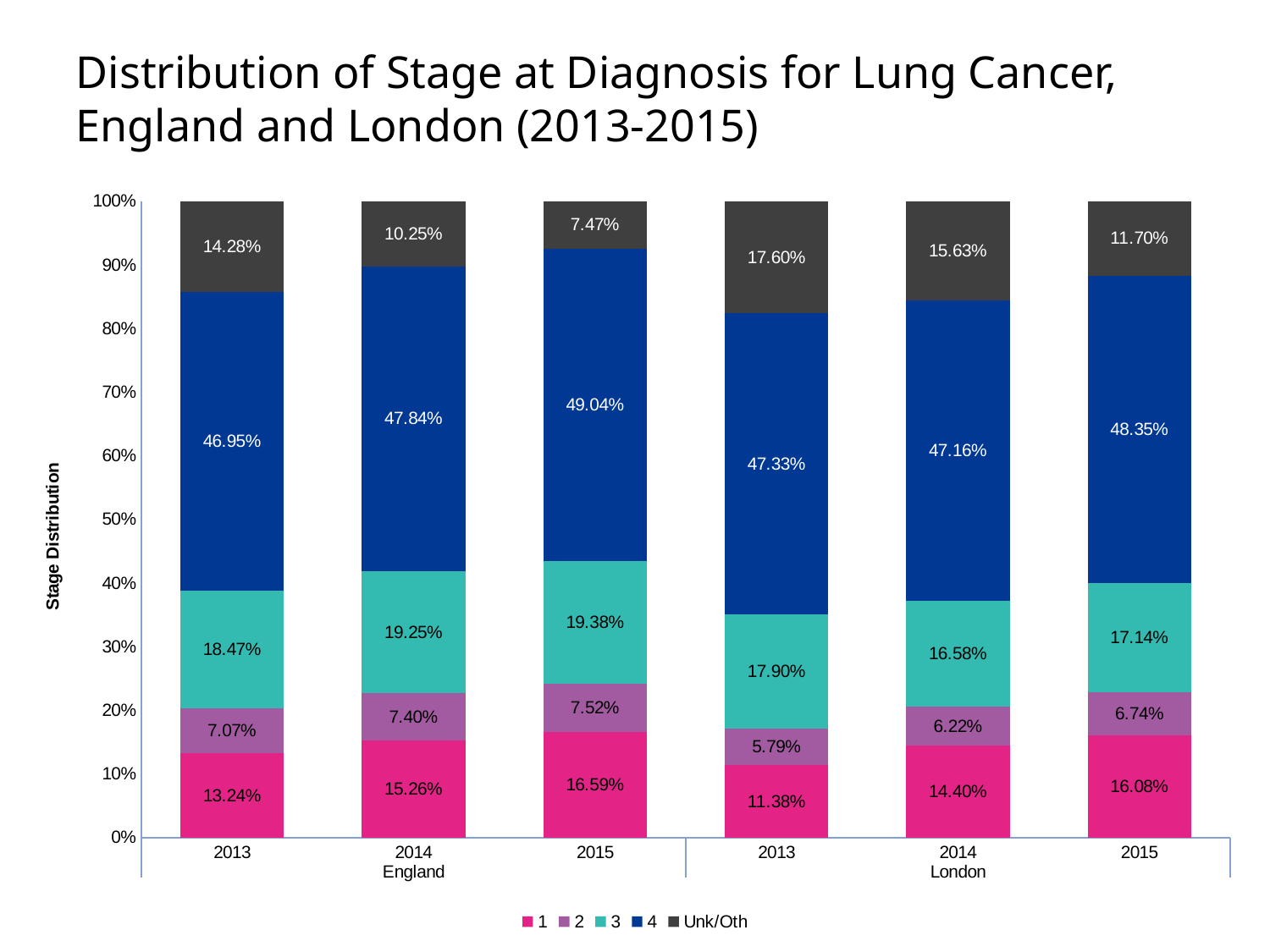
Does the stage 1 share for England rise or fall from 2013 to 2015? Rise Which bar has the lowest stage 2 share? London 2013 What type of chart is shown on the slide? Stacked bar chart What percentage of lung cancer cases in England in 2015 were diagnosed at stage 4? 49.04% Which bar has the highest Unk/Oth share? London 2013 By how many percentage points did the stage 4 share in England change from 2013 to 2015? 2.09 percentage points What is the Unk/Oth share for London in 2014? 15.63% How many series does the legend list? 5 Which has the larger stage 3 share, England 2014 or London 2014? England 2014 What is the stage 1 share for London in 2013? 11.38% How many stacked bars are shown in the chart? 6 What is the difference between the stage 1 share in England 2014 and London 2014? 0.86 percentage points